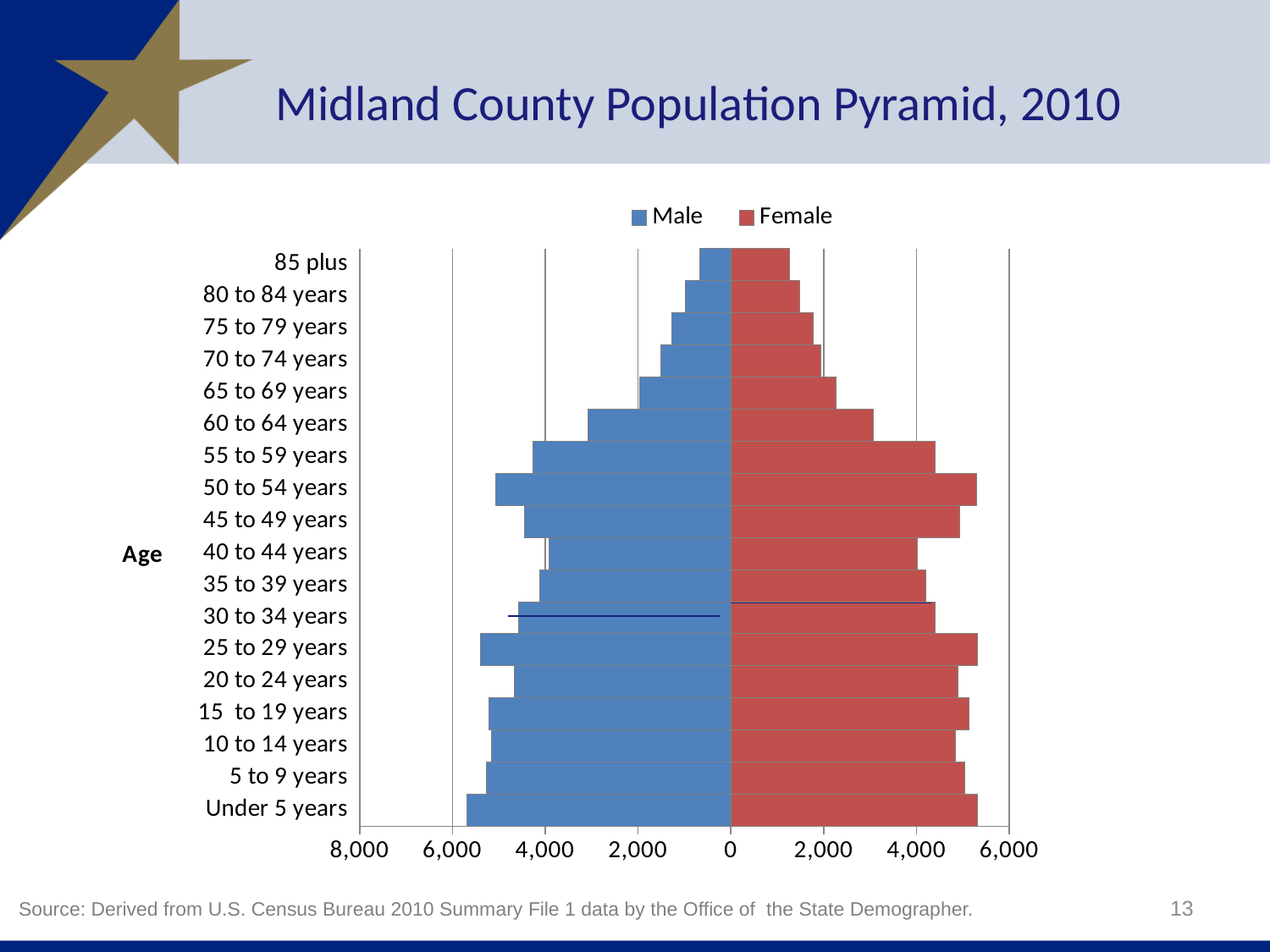
Is the Female value for 55 to 59 years greater or less than 4,000? greater How many series does the legend list? 2 How many age groups are shown on the vertical axis? 18 Which age group has the longest Male bar? Under 5 years What kind of chart is shown on the slide? bar chart Is the Male value for 70 to 74 years greater or less than 2,000? less Which age group has the shortest Female bar? 85 plus Moving from 50 to 54 years up to 85 plus, do the Male bars get longer or shorter? shorter Which age group has the shortest Male bar? 85 plus For the 85 plus age group, which is larger, the Male bar or the Female bar? Female Is the Male value for 50 to 54 years greater or less than 4,000? greater